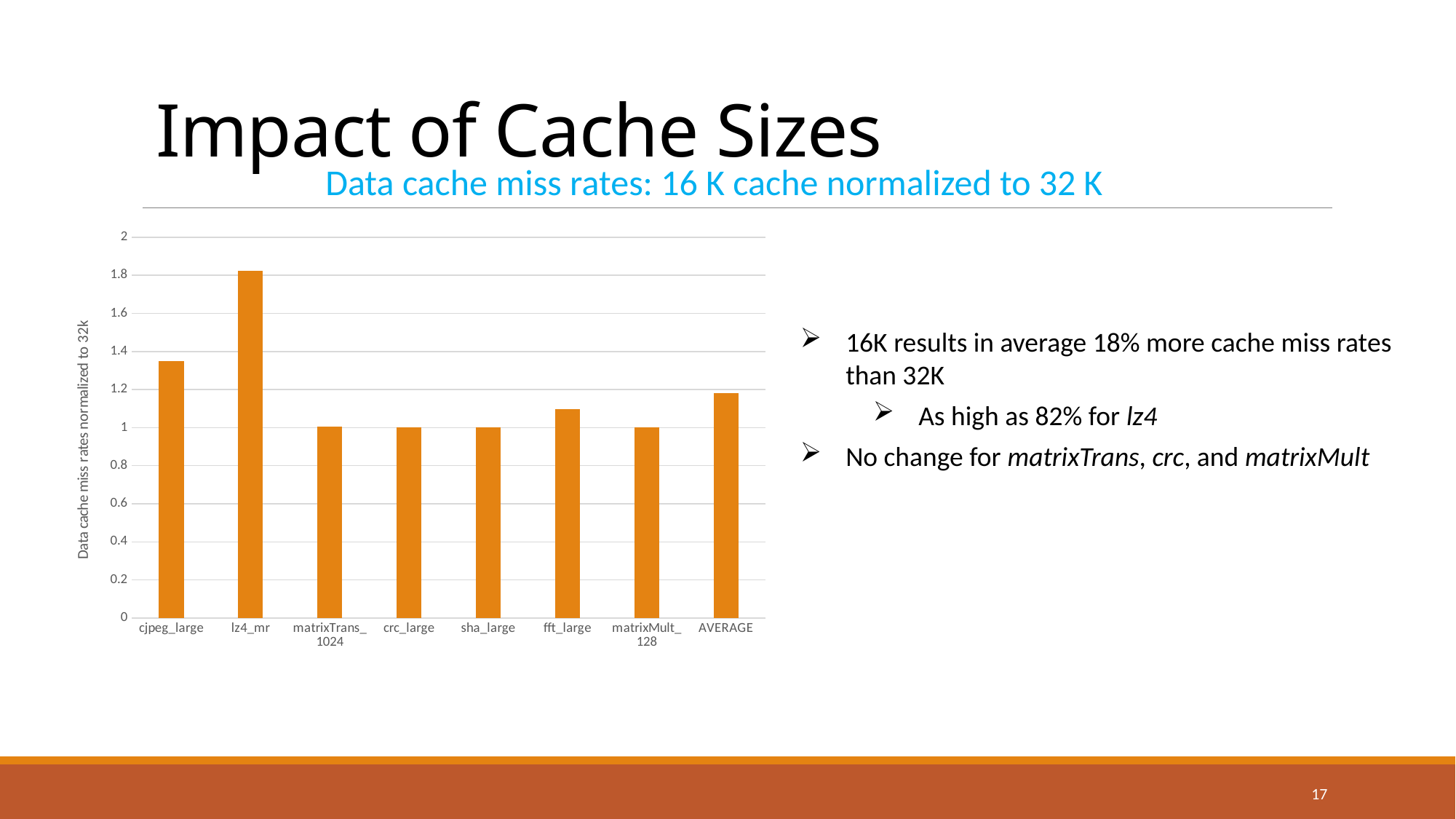
Is the value for lz4_mr greater or less than 1.6? greater What kind of chart is shown on the slide? bar chart Which has a larger value, cjpeg_large or fft_large? cjpeg_large What is the title of the chart? Data cache miss rates: 16 K cache normalized to 32 K Is the value for fft_large greater or less than 1.2? less What is the normalized data cache miss rate for crc_large? 1 What is the label on the y axis of the chart? Data cache miss rates normalized to 32k Is the value for cjpeg_large greater or less than 1.2? greater Which has a larger value, lz4_mr or cjpeg_large? lz4_mr Which category has the highest normalized data cache miss rate? lz4_mr How many categories are plotted along the x axis of the chart? 8